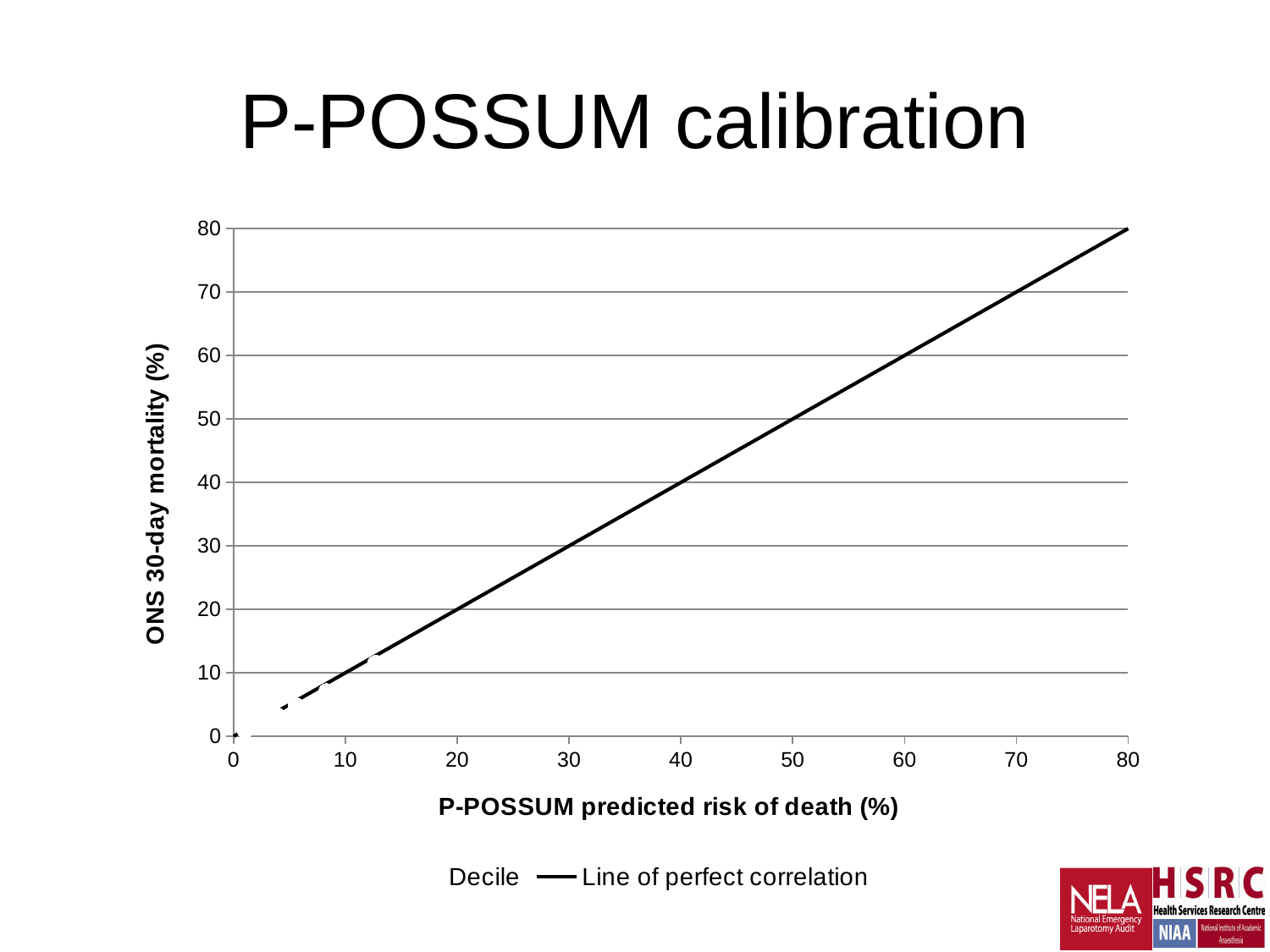
Is the value of the line of perfect correlation at a predicted risk of 60 greater or less than 50? greater What is the highest value shown on the y axis? 80 What is the title of the chart? P-POSSUM calibration What is the value of the line of perfect correlation at a P-POSSUM predicted risk of death of 40? 40 Does the line of perfect correlation rise or fall as P-POSSUM predicted risk of death increases? rise Is the value of the line of perfect correlation at a predicted risk of 20 greater or less than 30? less What is the label of the x axis? P-POSSUM predicted risk of death (%) How many series does the legend list? 2 What is the value of the line of perfect correlation at a P-POSSUM predicted risk of death of 80? 80 What kind of chart is shown on the slide? line chart